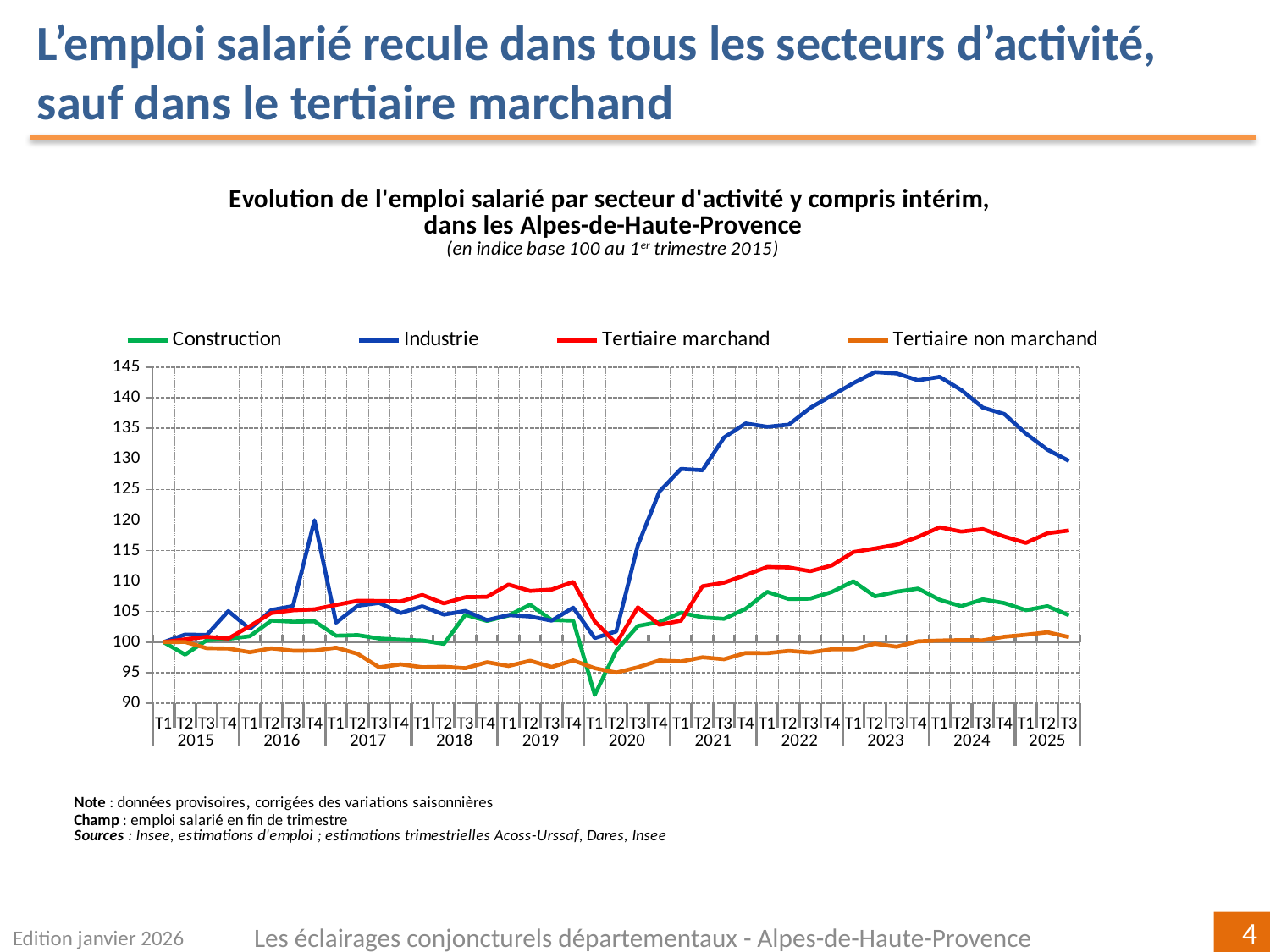
Which series has the highest value at T3 2025? Industrie How many years are labelled on the x axis? 11 Is the value for Construction at T1 2020 greater or less than 95? less How many series does the legend list? 4 Is the value for Industrie at T3 2025 greater or less than 125? greater At T3 2025, which is larger: the value for Industrie or the value for Construction? Industrie Is the value for Tertiaire marchand at T3 2025 greater or less than 115? greater What kind of chart is shown on the slide? line chart Which series has the lowest value at T1 2020? Construction Does the Industrie series rise or fall between T2 2023 and T3 2025? fall Which colour is used for the Tertiaire non marchand series? orange